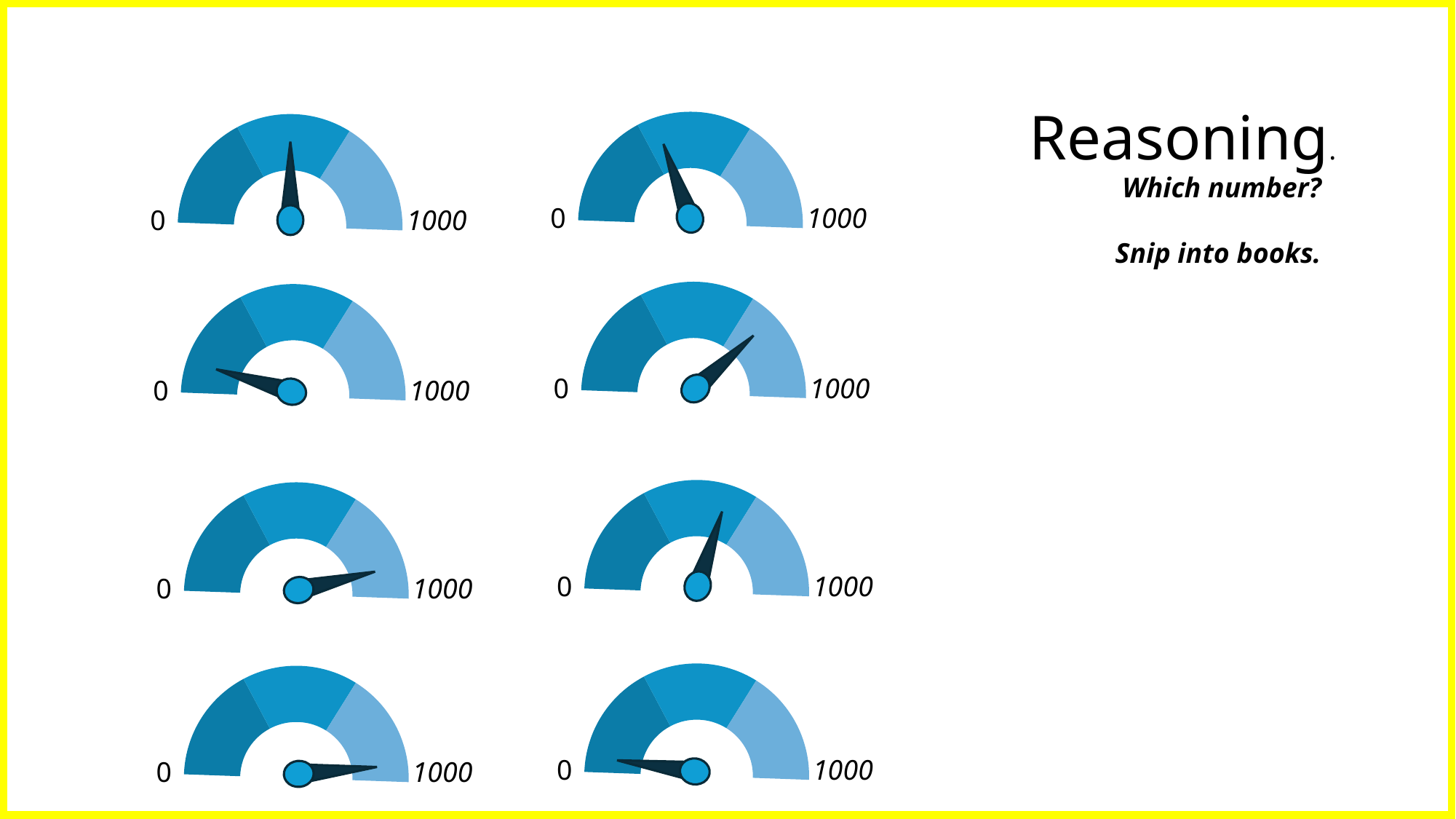
What is the maximum value marked on each gauge's scale? 1000 Which gauge shows the larger value: the top-left gauge or the bottom-right gauge? Top-left gauge Which gauge shows the smaller value: the top-left gauge or the second-row left gauge? Second-row left gauge What kind of chart is used on this slide? Gauge chart What is the minimum value marked on each gauge's scale? 0 Which gauge shows the larger value: the third-row left gauge or the third-row right gauge? Third-row left gauge How many gauge charts are shown on the slide? 8